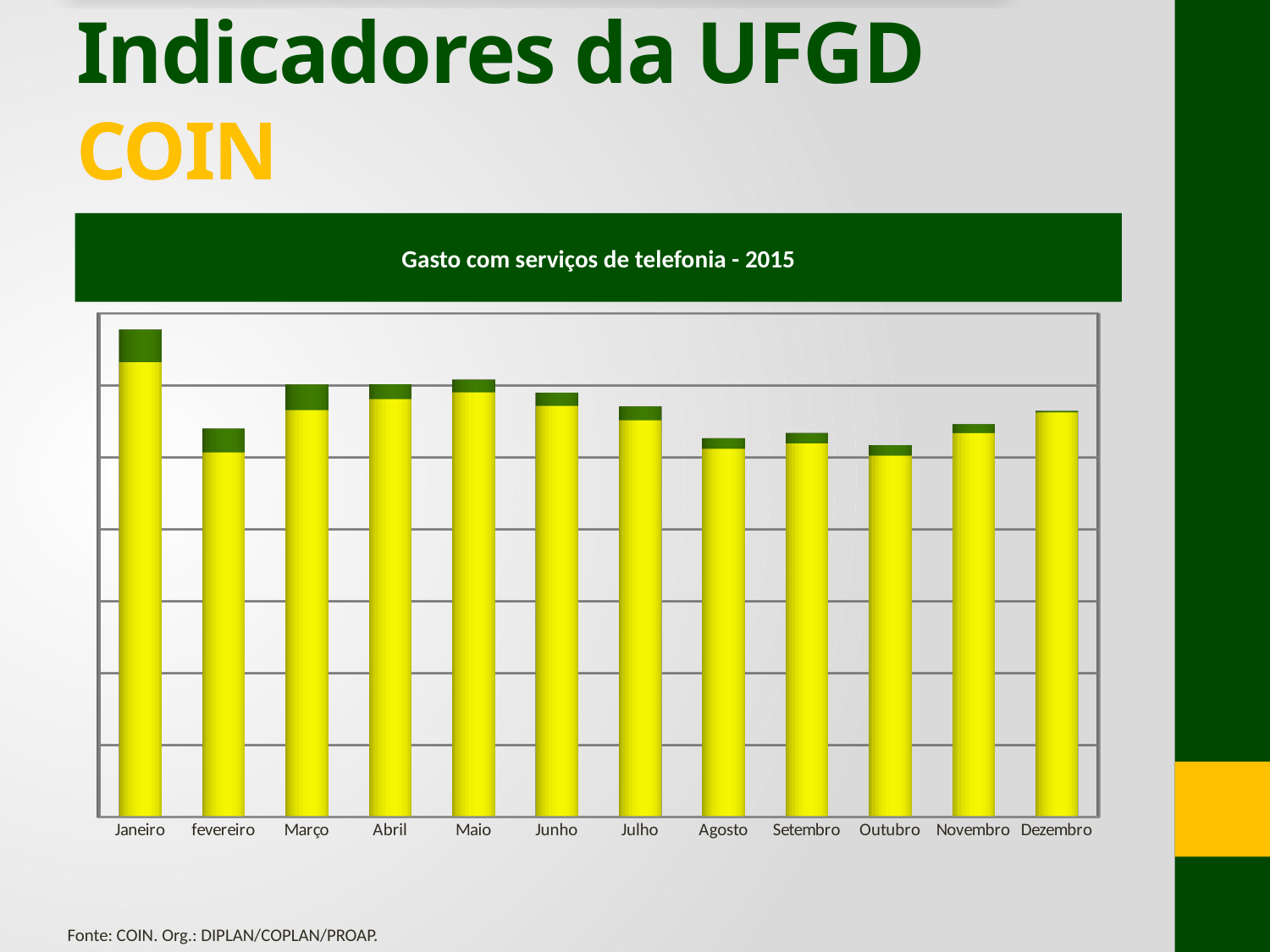
Which month has the highest bar? Janeiro What is the title of the chart? Gasto com serviços de telefonia - 2015 Do the values rise or fall from fevereiro to Março? rise Do the values rise or fall from Maio to Outubro? fall Which is larger, the value for Março or the value for Agosto? Março What is the main colour of the bars in the chart? yellow What kind of chart is shown on the slide? bar chart How many months (categories) are plotted on the x axis? 12 Which is larger, the value for Janeiro or the value for fevereiro? Janeiro Which is larger, the value for Maio or the value for Julho? Maio